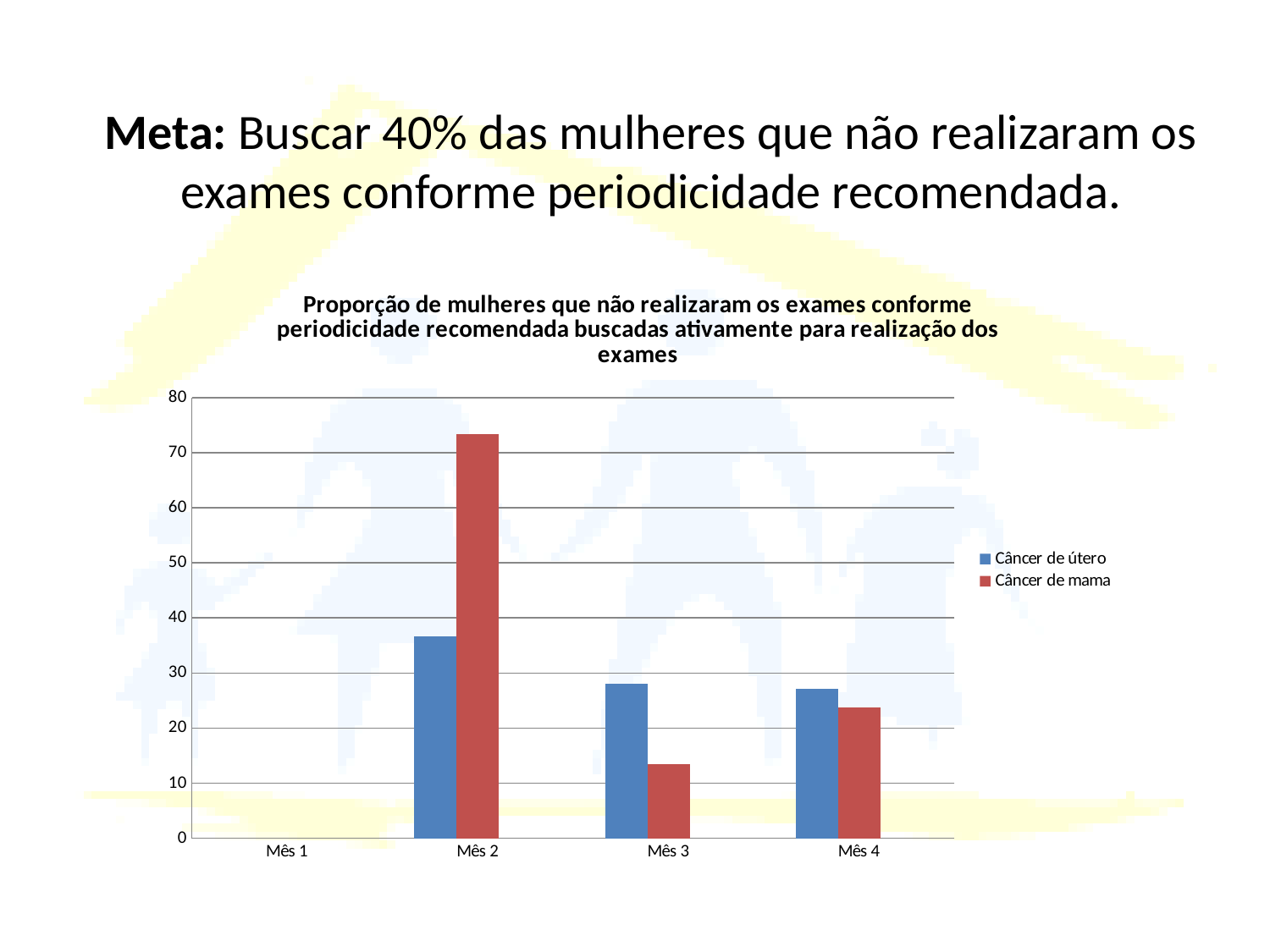
In Mês 3, which is larger: Câncer de útero or Câncer de mama? Câncer de útero In Mês 2, which is larger: Câncer de útero or Câncer de mama? Câncer de mama In which month is the Câncer de mama value highest? Mês 2 Does the Câncer de útero value rise or fall from Mês 2 to Mês 4? fall How many categories are shown on the x axis? 4 Is the value for Câncer de mama in Mês 2 greater or less than 70? greater What kind of chart is shown on the slide? bar chart Which series does the red bar represent? Câncer de mama Is the value for Câncer de mama in Mês 3 greater or less than 20? less How many series does the legend list? 2 Is the value for Câncer de útero in Mês 2 greater or less than 40? less In which month is the Câncer de útero value highest? Mês 2